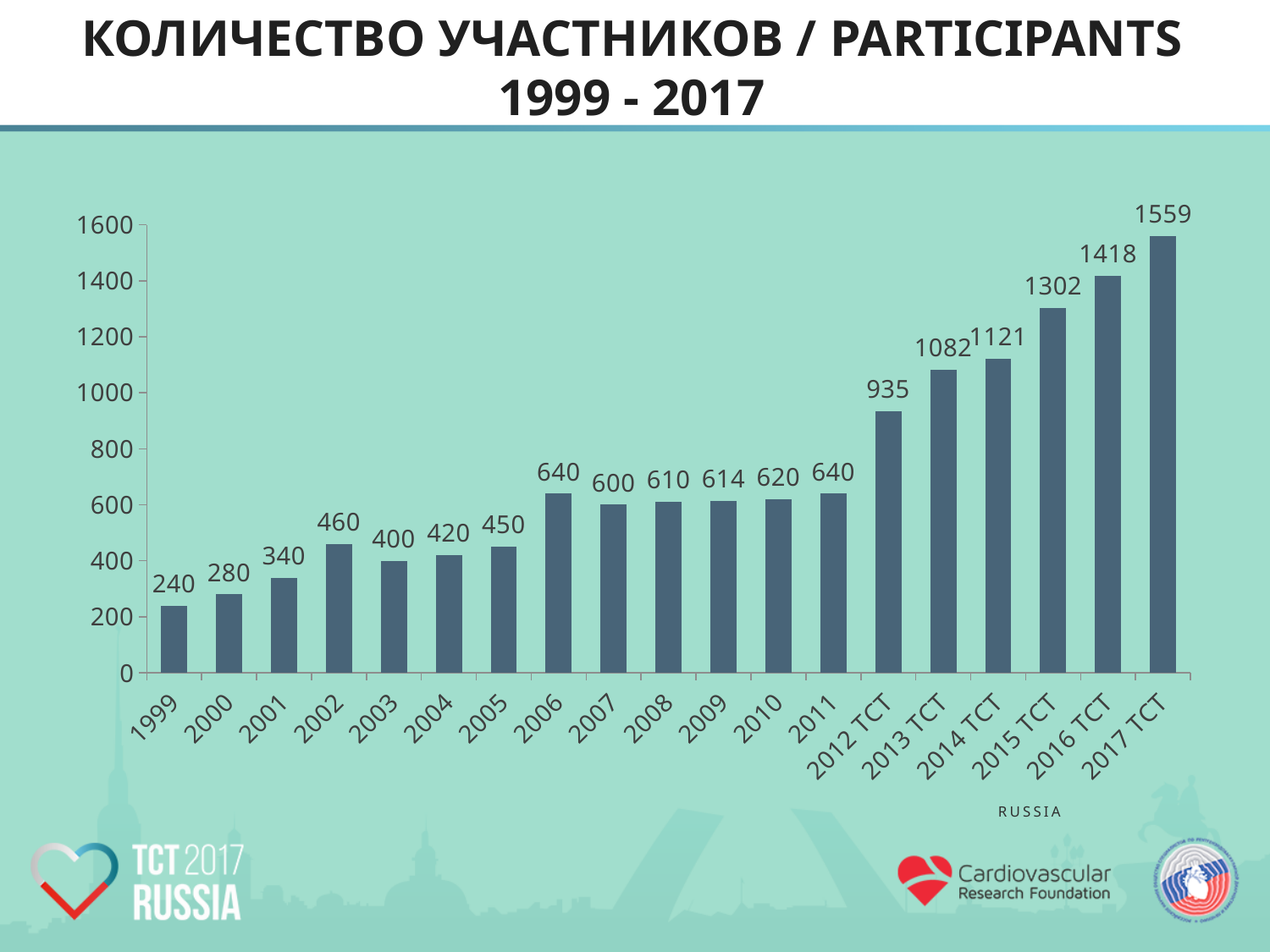
Which category has the lowest number of participants? 1999 What is the number of participants for 2017 TCT? 1559 What is the number of participants for 2008? 610 Which category has the highest number of participants? 2017 TCT Which has more participants, 2002 or 2003? 2002 What kind of chart is shown on the slide? Bar chart What is the difference in participants between 2012 TCT and 2011? 295 What is the number of participants for 1999? 240 What is the difference in participants between 2017 TCT and 2016 TCT? 141 What is the title of the chart? КОЛИЧЕСТВО УЧАСТНИКОВ / PARTICIPANTS 1999 - 2017 How many categories are shown on the x axis? 19 Do the participant numbers generally rise or fall from 2012 TCT to 2017 TCT? Rise